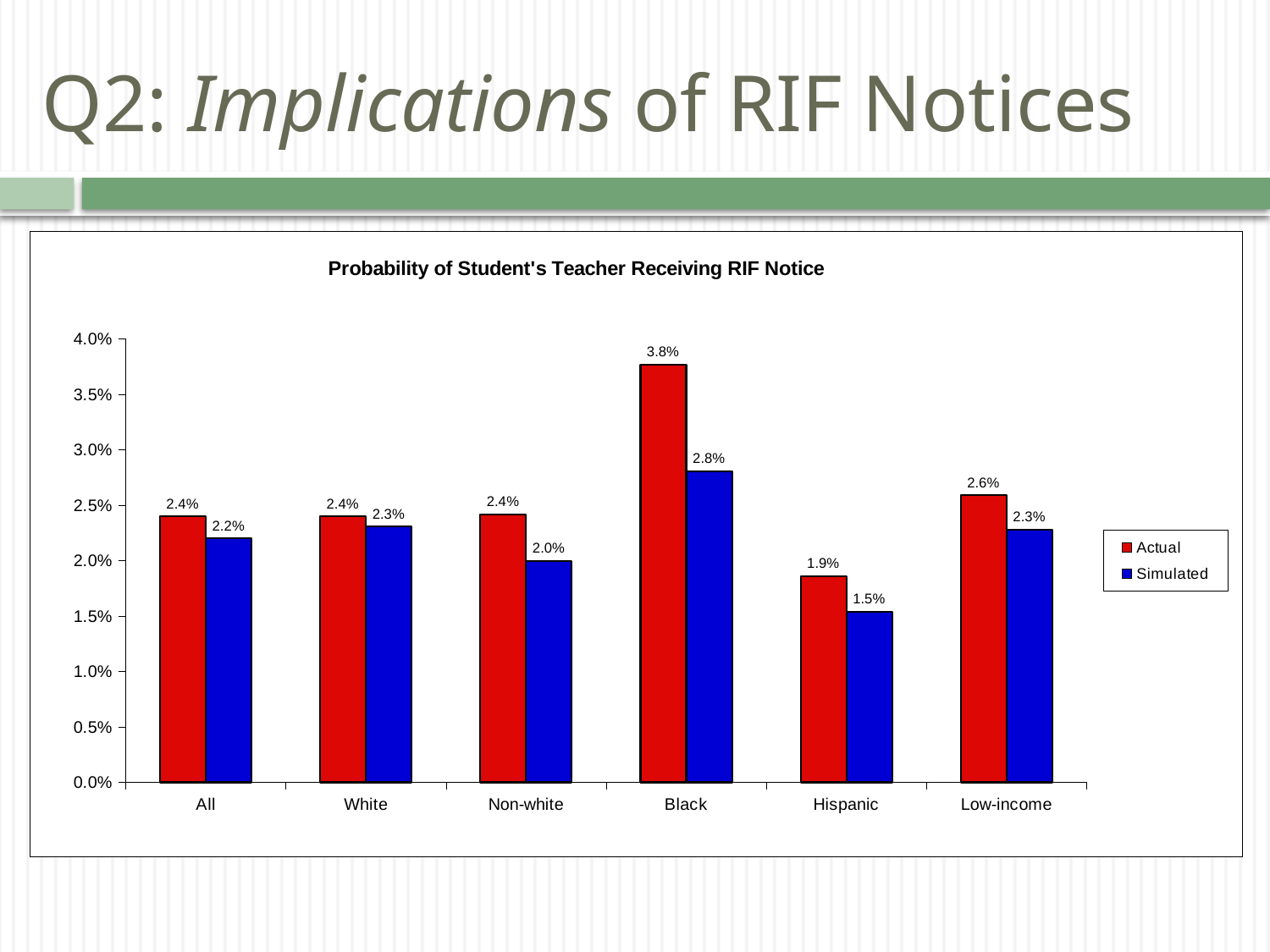
What is the difference between the Actual and Simulated values for Black? 1.0% How many categories are shown on the x axis? 6 Which is larger for Low-income, the Actual value or the Simulated value? Actual Which category has the lowest Simulated value? Hispanic What is the Actual value for Low-income? 2.6% What is the Actual value for Black? 3.8% What is the Simulated value for Non-white? 2.0% Which category has the highest Actual value? Black What is the title of the chart? Probability of Student's Teacher Receiving RIF Notice How many series does the legend list? 2 What kind of chart is shown on the slide? Bar chart What is the Simulated value for Hispanic? 1.5%